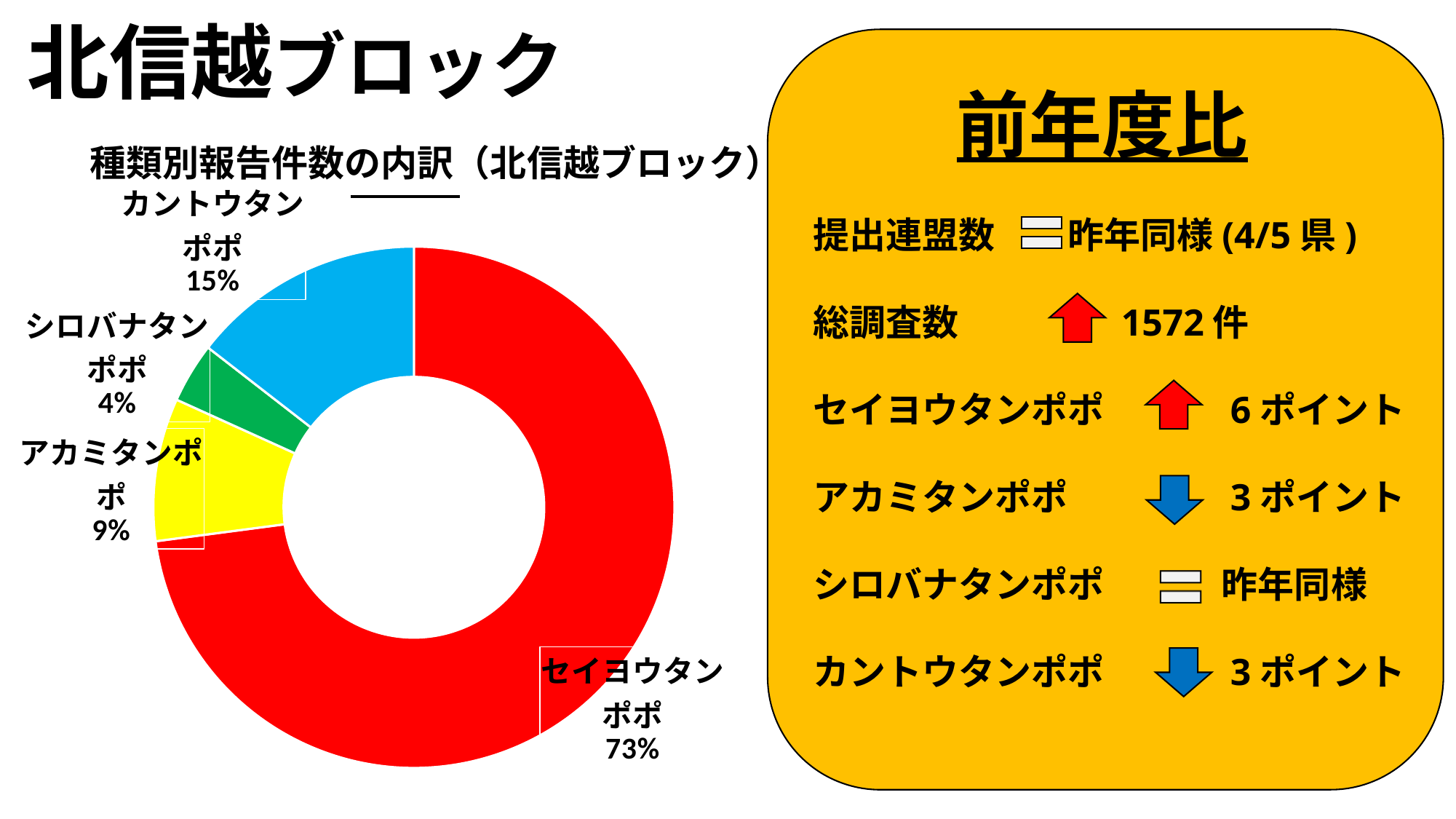
What is the title of the chart? 種類別報告件数の内訳（北信越ブロック） Which has a larger share, カントウタンポポ or アカミタンポポ? カントウタンポポ How many categories are shown in the chart? 4 What percentage is shown for シロバナタンポポ in the chart? 4% What percentage is shown for カントウタンポポ in the chart? 15% What percentage is shown for アカミタンポポ in the chart? 9% What kind of chart is shown on the slide? Doughnut (pie) chart What share of the doughnut chart does セイヨウタンポポ account for? 73% Which category has the largest share in the chart? セイヨウタンポポ How many percentage points larger is セイヨウタンポポ's share than カントウタンポポ's? 58 Which category has the smallest share in the chart? シロバナタンポポ How many percentage points larger is アカミタンポポ's share than シロバナタンポポ's? 5